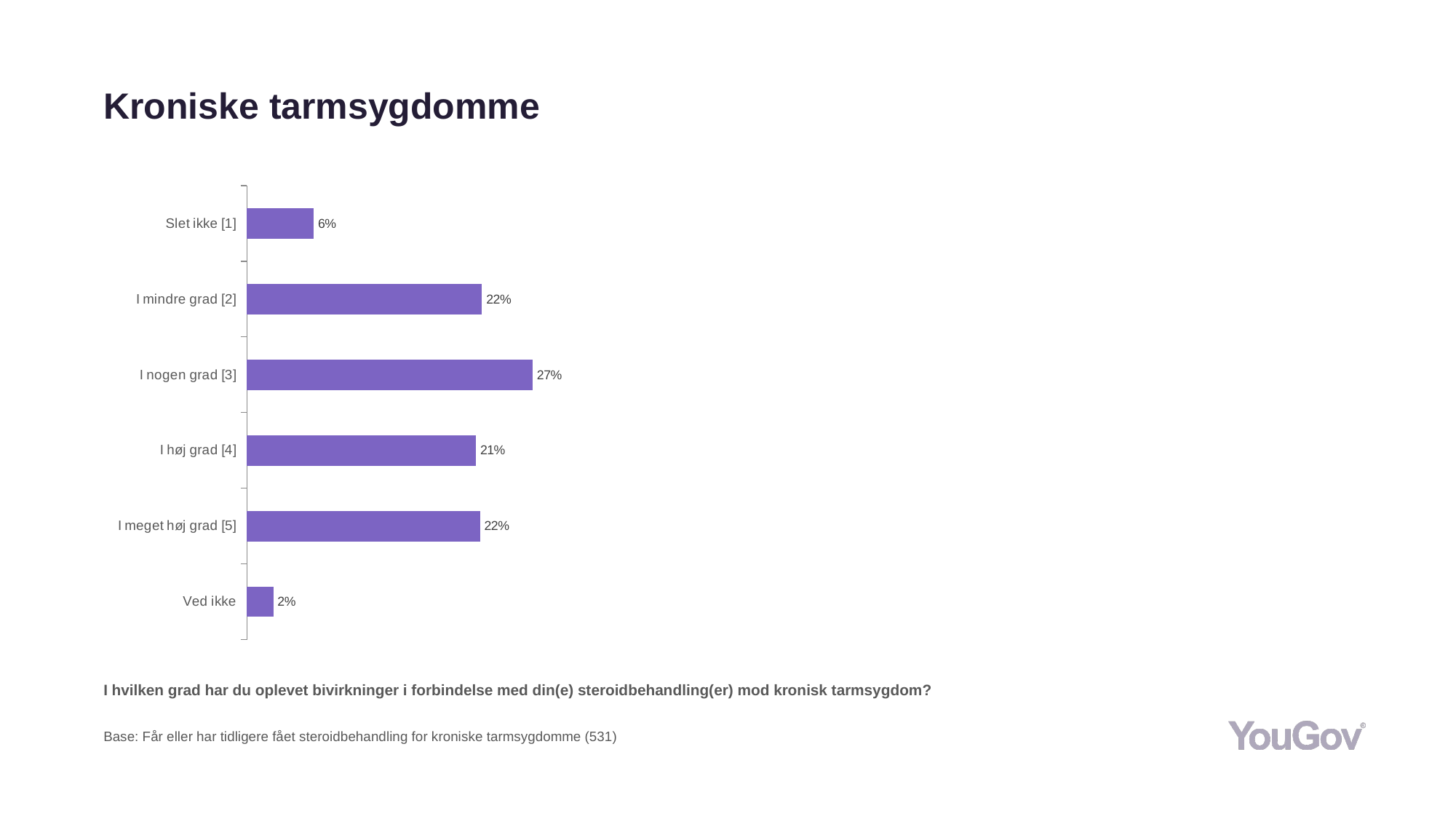
Which is larger, the value for "I mindre grad [2]" or the value for "Slet ikke [1]"? I mindre grad [2] Which category has the lowest value? Ved ikke How many categories are shown in the chart? 6 What is the value for "Slet ikke [1]"? 6% What is the value for "I nogen grad [3]"? 27% Which category has the highest value? I nogen grad [3] What is the difference between the values for "I meget høj grad [5]" and "I høj grad [4]"? 1 percentage point What is the title of the slide? Kroniske tarmsygdomme What is the difference between the values for "I nogen grad [3]" and "Slet ikke [1]"? 21 percentage points What kind of chart is shown on the slide? Bar chart What is the value for "Ved ikke"? 2% What is the value for "I høj grad [4]"? 21%